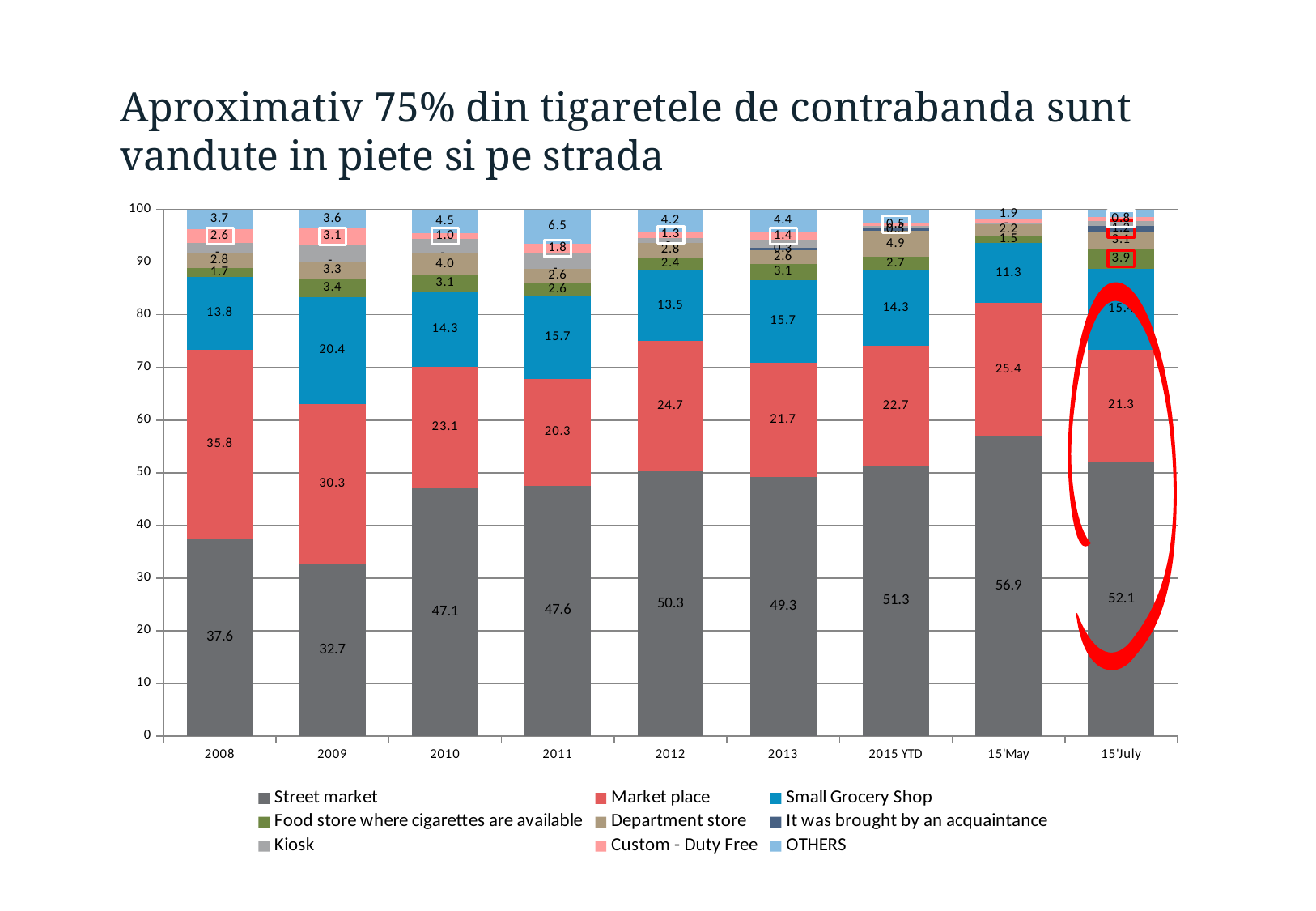
Which category has the lowest Street market value? 2009 How many categories are shown on the x axis? 9 Does the Street market value rise or fall from 2009 to 2012? Rise What kind of chart is shown on the slide? Stacked bar chart Which category has the highest Street market value? 15'May Which is larger, the Market place value for 2008 or for 2012? 2008 What is the Market place value for 2009? 30.3 What is the difference between the Street market values for 15'May and 15'July? 4.8 How many series does the legend list? 9 What is the OTHERS value for 2011? 6.5 What is the Street market value for 2008? 37.6 What is the Small Grocery Shop value for 2009? 20.4